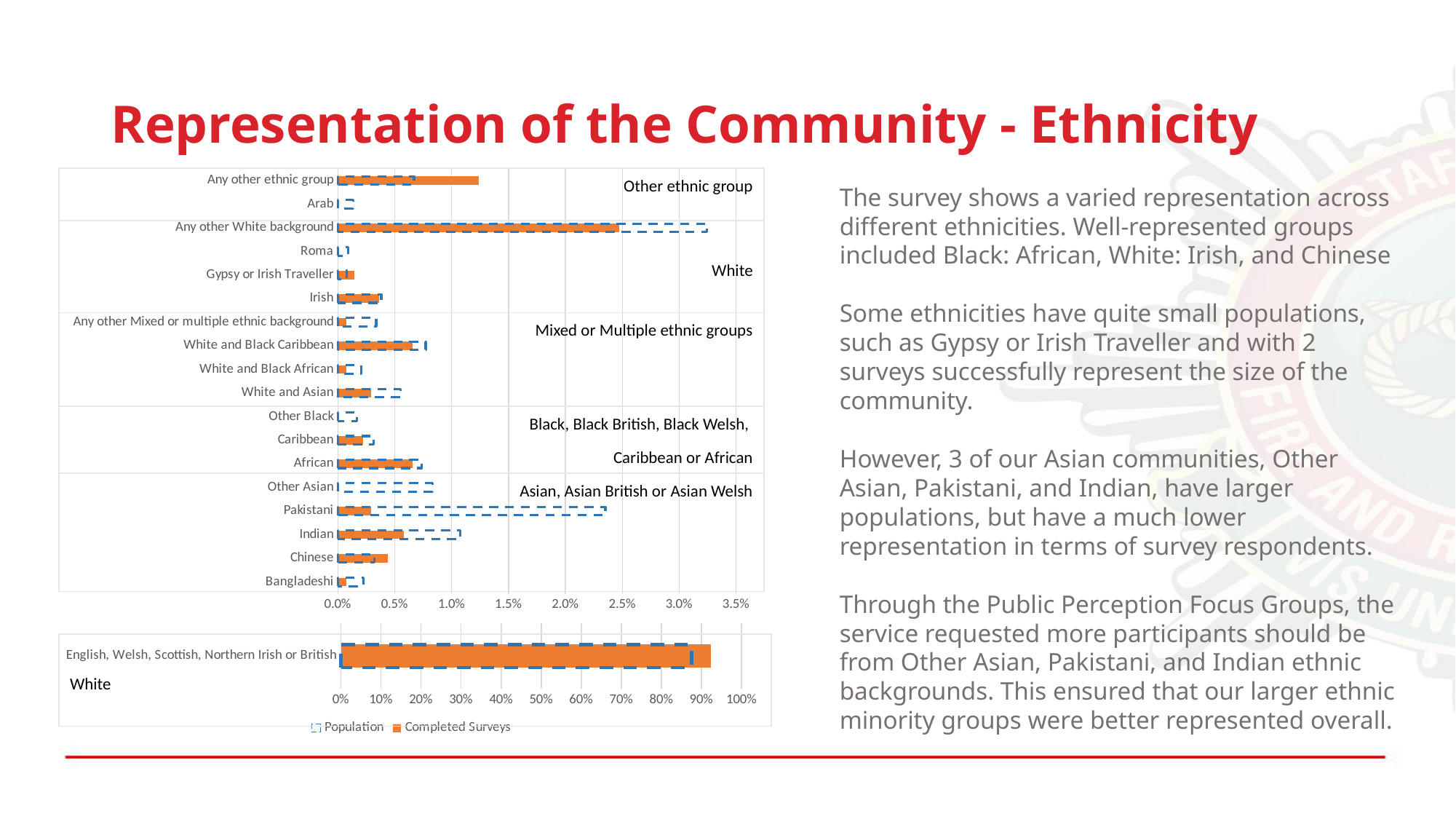
In the top chart, which category has the highest Completed Surveys value? Any other White background How many ethnic categories are plotted in the top chart? 18 In the top chart, for Pakistani, which is larger: Population or Completed Surveys? Population In the top chart, is the Population value for Any other White background greater or less than 3.0%? greater How many series does the legend list? 2 What kind of chart is the top chart on the slide? bar chart In the bottom chart, is the Completed Surveys value for English, Welsh, Scottish, Northern Irish or British greater or less than 90%? greater In the top chart, which category has the highest Population value? Any other White background What are the two series named in the legend? Population and Completed Surveys In the bottom chart, for English, Welsh, Scottish, Northern Irish or British, which is larger: Population or Completed Surveys? Completed Surveys In the top chart, is the Completed Surveys value for Any other ethnic group greater or less than 1.0%? greater